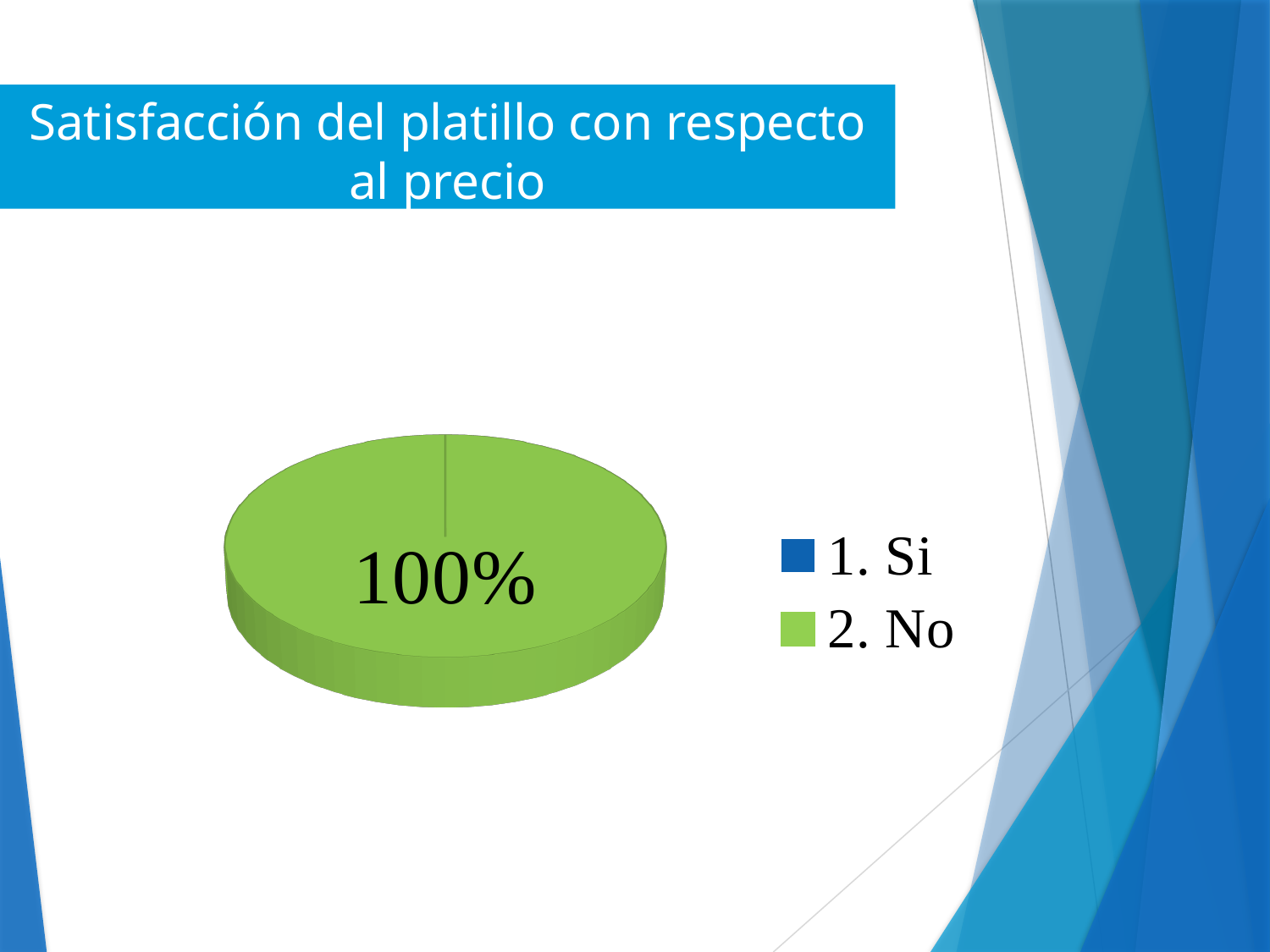
What colour represents "2. No" in the legend? green Which category has the largest share of the pie? 2. No What kind of chart is shown on the slide? pie chart Which legend entry has no visible slice in the pie? 1. Si What share of the pie does "2. No" represent? 100% What is the title of the chart? Satisfacción del platillo con respecto al precio How many entries does the legend list? 2 What is the only data label printed on the pie? 100%